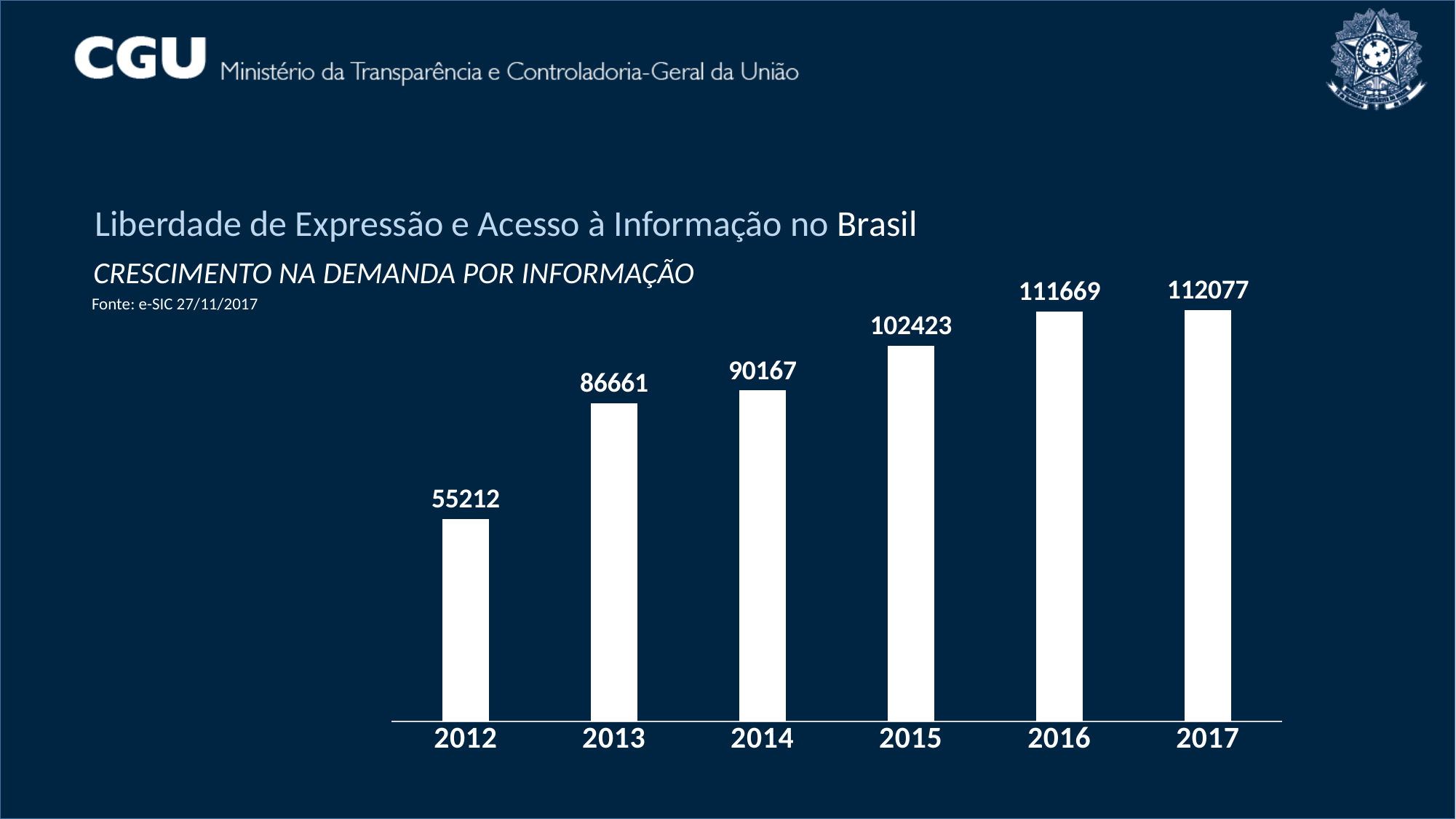
How many years are shown on the x axis? 6 What is the difference between the values for 2017 and 2012? 56865 What is the value for 2017? 112077 What kind of chart is shown on the slide? bar chart What is the value for 2015? 102423 Do the values rise or fall from 2012 to 2017? rise Which is larger, the value for 2014 or the value for 2015? 2015 What is the value for 2012? 55212 Which year has the highest value? 2017 What is the difference between the values for 2016 and 2015? 9246 What is the difference between the values for 2013 and 2012? 31449 Which year has the lowest value? 2012